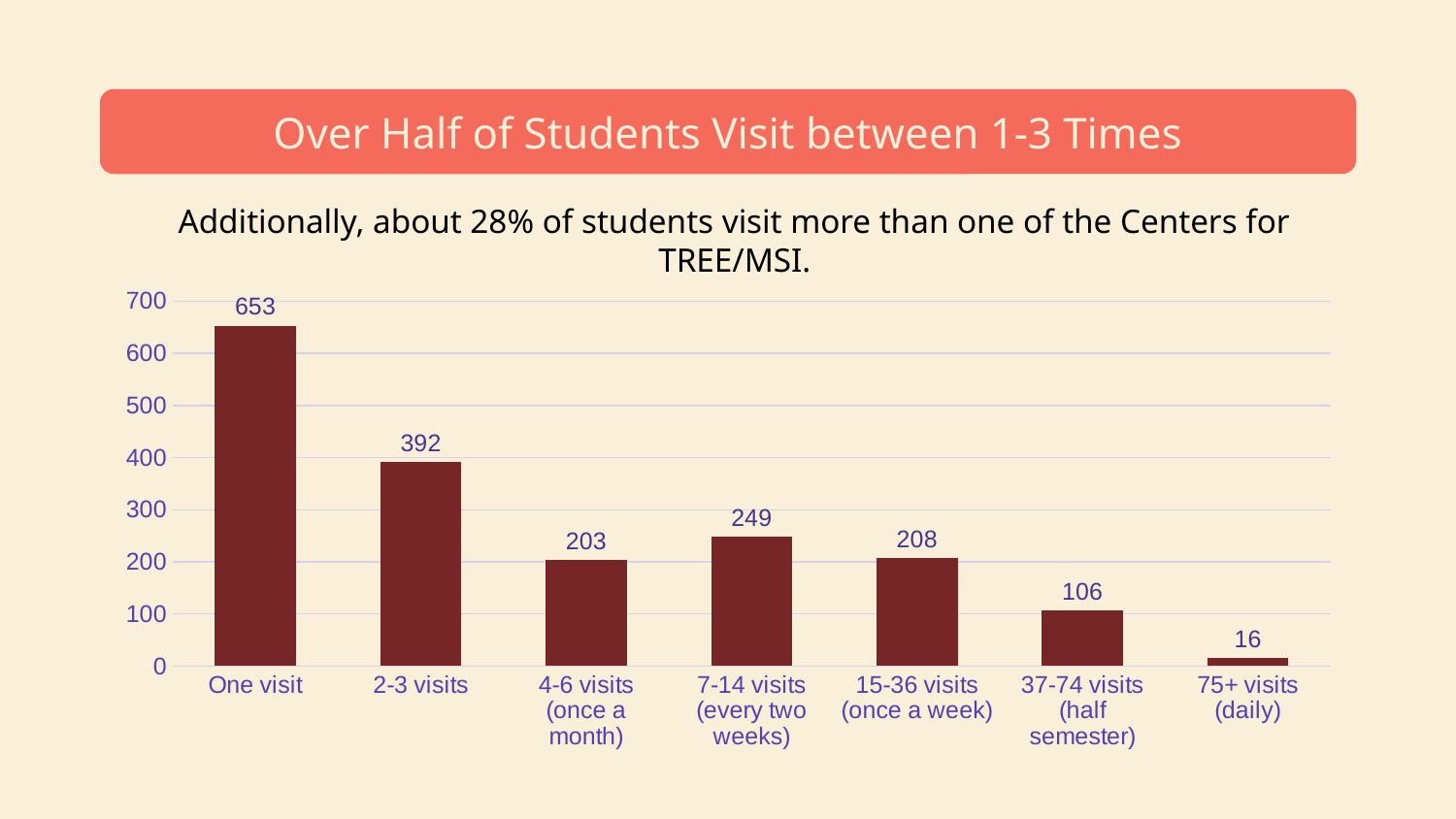
What is the value for the "2-3 visits" category? 392 What is the difference between the values for "37-74 visits (half semester)" and "75+ visits (daily)"? 90 Which is larger, the value for "7-14 visits (every two weeks)" or "4-6 visits (once a month)"? 7-14 visits (every two weeks) What is the value for "75+ visits (daily)"? 16 Which category has the lowest value? 75+ visits (daily) What is the value for the "One visit" category? 653 What kind of chart is shown on the slide? Bar chart Which category has the highest value? One visit How many categories are shown on the x axis? 7 What is the difference between the values for "One visit" and "2-3 visits"? 261 What is the value for "15-36 visits (once a week)"? 208 What is the title shown in the banner above the chart? Over Half of Students Visit between 1-3 Times